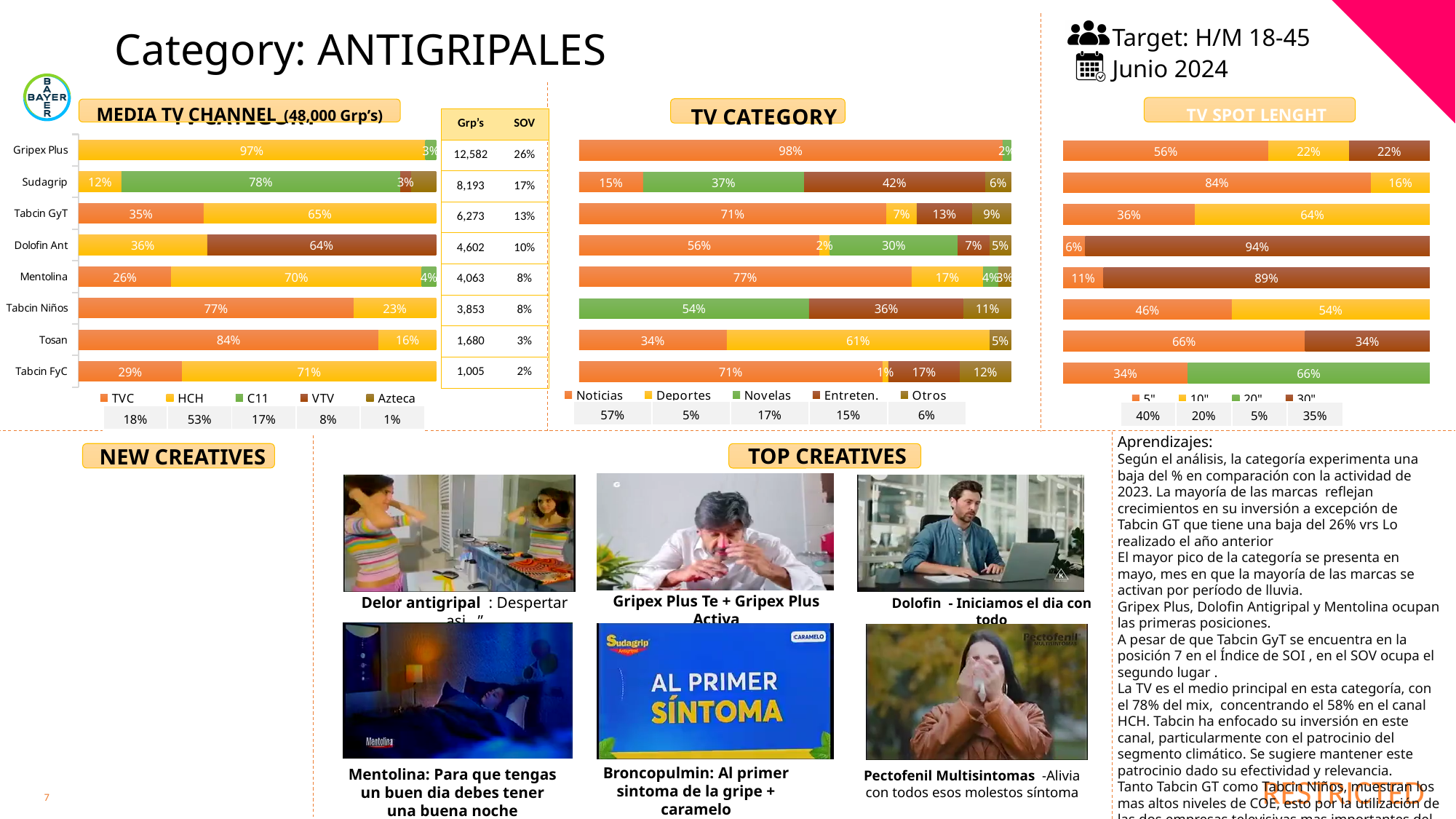
In the TV SPOT LENGHT chart, how many spot lengths does the legend list? 4 In the TV SPOT LENGHT chart, what share of Dolofin Ant is 30" spots? 94% In the TV CATEGORY chart, what share of Tosan is in Deportes? 61% In the MEDIA TV CHANNEL chart, what share of Tosan is on TVC? 84% In the TV CATEGORY chart, what share of Gripex Plus is in Noticias? 98% What type of chart is the TV CATEGORY chart? Stacked bar chart In the MEDIA TV CHANNEL chart, which brand has the largest share on VTV? Dolofin Ant In the TV SPOT LENGHT chart, what is the difference between the 5" share and the 10" share for Sudagrip? 68% In the MEDIA TV CHANNEL chart, how many channels does the legend list? 5 In the TV CATEGORY chart, which is larger for Tabcin Niños: Novelas or Entreten.? Novelas How many brands are plotted in the MEDIA TV CHANNEL chart? 8 In the MEDIA TV CHANNEL chart, what share of Gripex Plus is on HCH? 97%